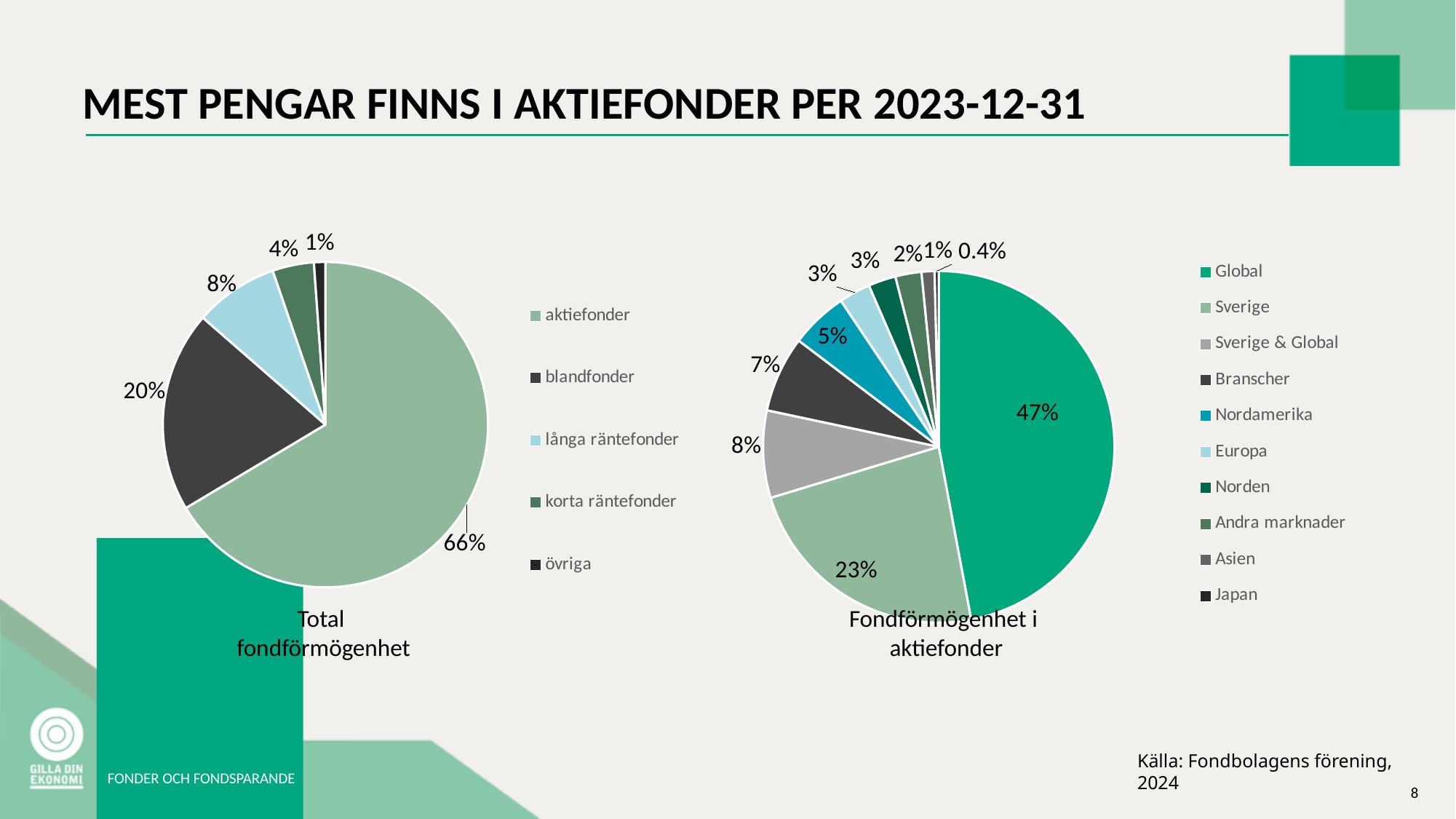
What type of chart is used for 'Total fondförmögenhet'? Pie chart In the 'Total fondförmögenhet' chart, what is the difference between the shares of blandfonder and långa räntefonder? 12% In the 'Fondförmögenhet i aktiefonder' chart, which is larger, Branscher or Nordamerika? Branscher In the 'Fondförmögenhet i aktiefonder' chart, which category has the largest share? Global In the 'Fondförmögenhet i aktiefonder' chart, what share does Sverige have? 23% In the 'Total fondförmögenhet' chart, which category has the smallest share? övriga In the 'Total fondförmögenhet' chart, how many categories does the legend list? 5 In the 'Fondförmögenhet i aktiefonder' chart, how many categories does the legend list? 10 In the 'Fondförmögenhet i aktiefonder' chart, what share does Japan have? 0.4% In the 'Total fondförmögenhet' chart, what share do aktiefonder have? 66% In the 'Fondförmögenhet i aktiefonder' chart, what share does Global have? 47% In the 'Total fondförmögenhet' chart, what share do blandfonder have? 20%